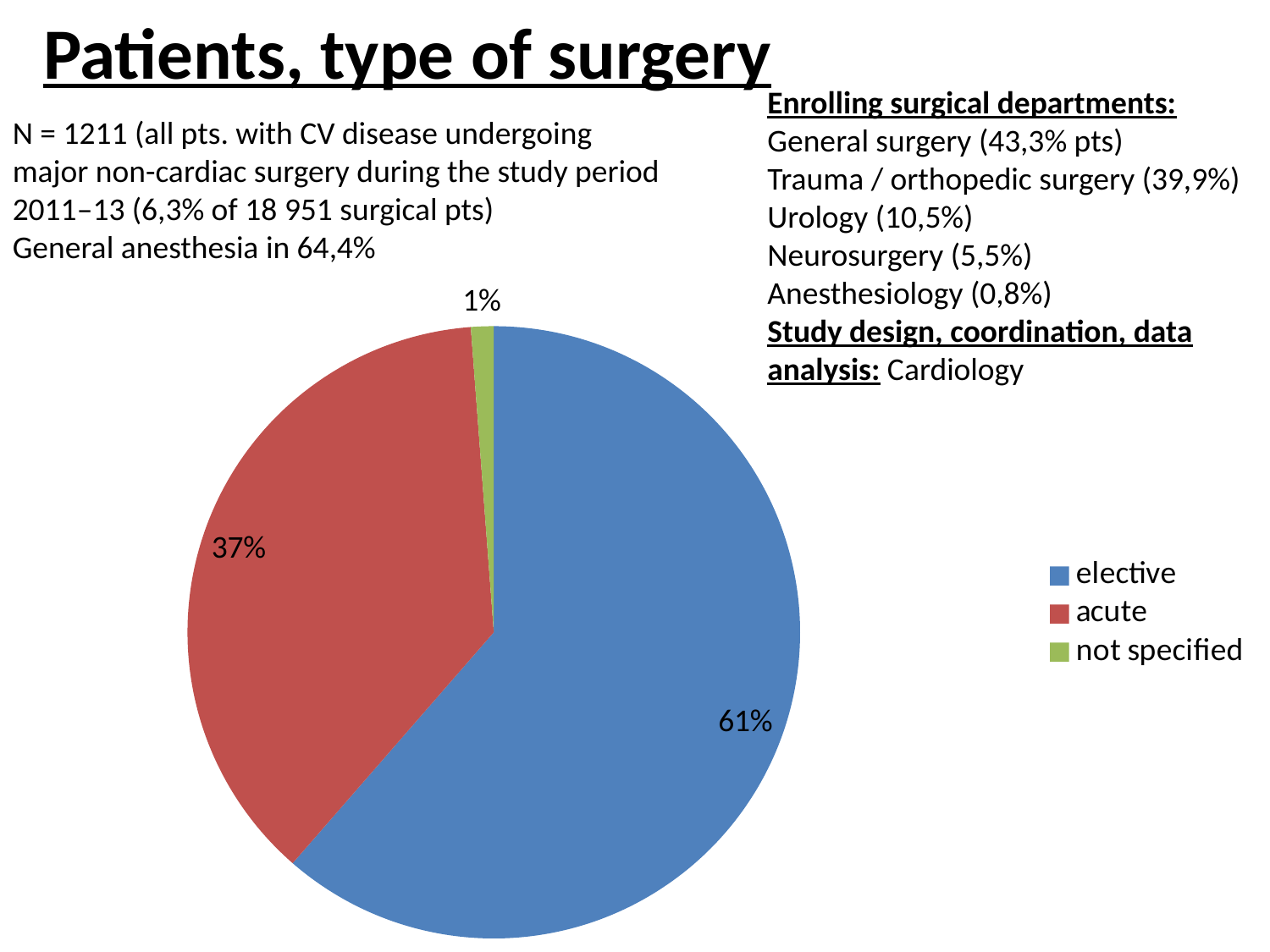
What share of the pie does the not specified slice represent? 1% Which category has the largest slice of the pie? elective How many slices does the pie chart have? 3 Which category has the smallest slice of the pie? not specified What share of the pie does the acute slice represent? 37% What share of the pie does the elective slice represent? 61% What colour is the acute slice in the pie chart? red What is the difference in percentage points between the elective and acute slices? 24 What kind of chart is shown on the slide? pie chart Which is larger, the elective slice or the acute slice? elective Which legend entry is shown in green? not specified How many entries does the legend list? 3